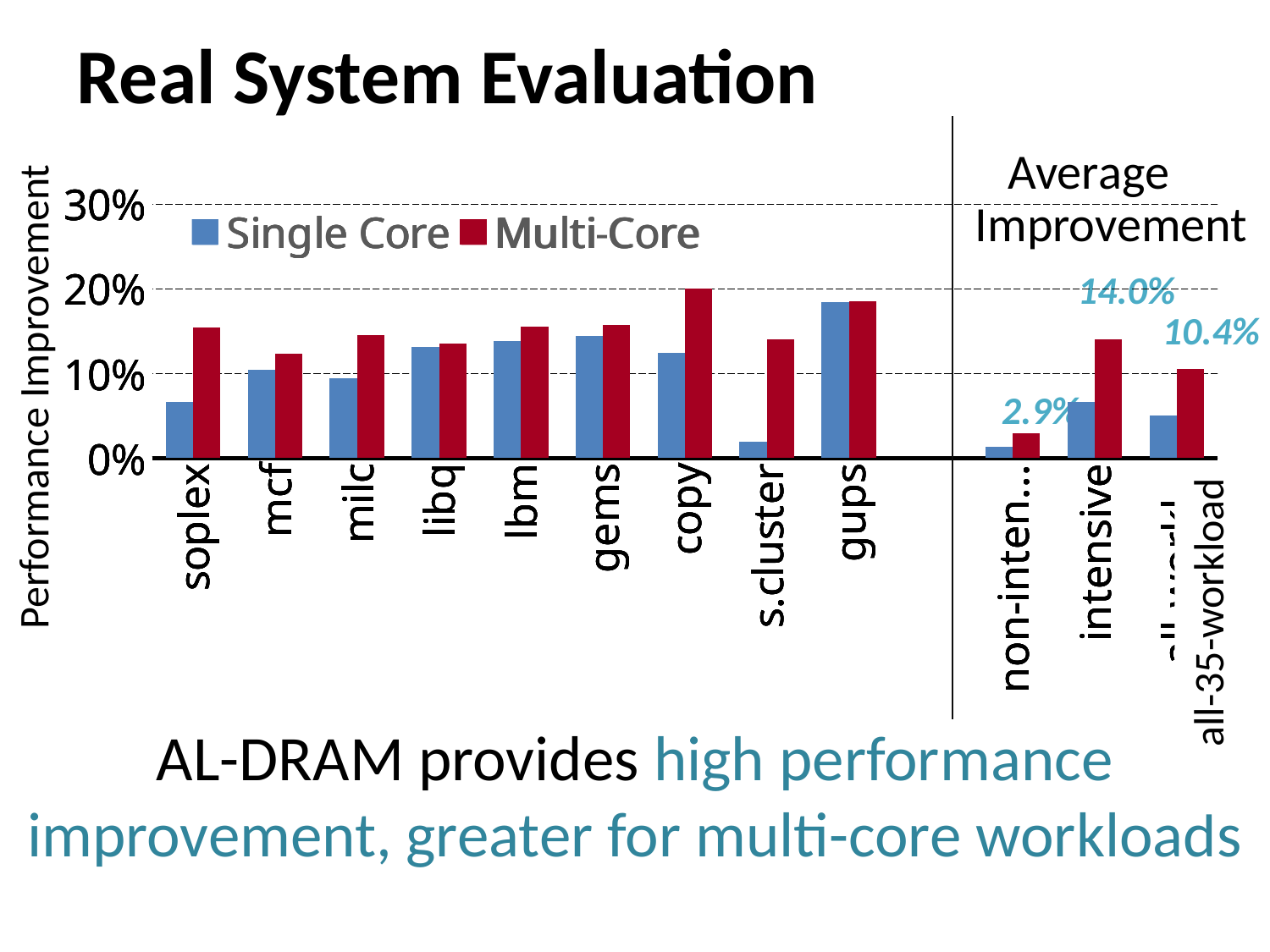
Among the nine benchmarks left of the vertical divider, which has the lowest Single Core performance improvement? s.cluster How many series does the legend list? 2 What is the Multi-Core average improvement for the intensive workloads? 14.0% Is the Single Core value for s.cluster greater or less than 10%? less Among the nine benchmarks left of the vertical divider, which has the highest Single Core performance improvement? gups What is the difference between the Multi-Core average improvement for intensive and for all-35-workload? 3.6% For s.cluster, which is larger: the Single Core or the Multi-Core performance improvement? Multi-Core Is the Single Core value for gups greater or less than 15%? greater What is the Multi-Core average improvement for all-35-workload? 10.4% What kind of chart is shown on the slide? bar chart What colour represents the Multi-Core series? red Is the Multi-Core value for copy greater or less than 15%? greater